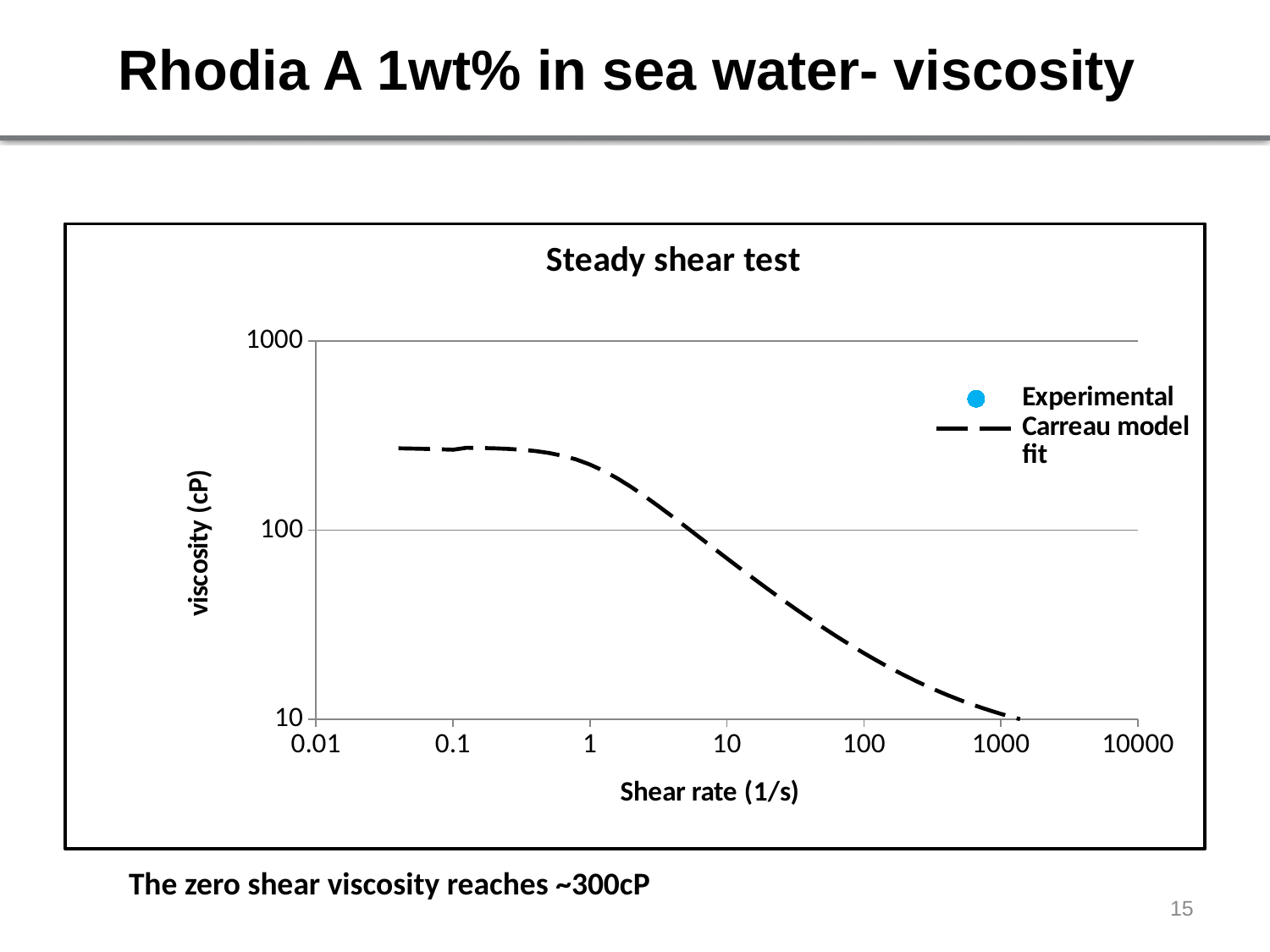
Is the viscosity of the Carreau model fit at a shear rate of 100 greater or less than 100? less Is the viscosity of the Carreau model fit at a shear rate of 0.1 greater or less than 100? greater Which is larger, the viscosity of the Carreau model fit at a shear rate of 1 or at a shear rate of 100? at a shear rate of 1 Is the viscosity of the Carreau model fit at a shear rate of 1 greater or less than 100? greater What is the title of the chart? Steady shear test How many series does the chart legend list? 2 What is the label of the y axis? viscosity (cP) What kind of chart is shown on the slide? line chart What are the two series named in the legend? Experimental and Carreau model fit What is the label of the x axis? Shear rate (1/s) Does the viscosity rise or fall as the shear rate increases along the x axis? fall